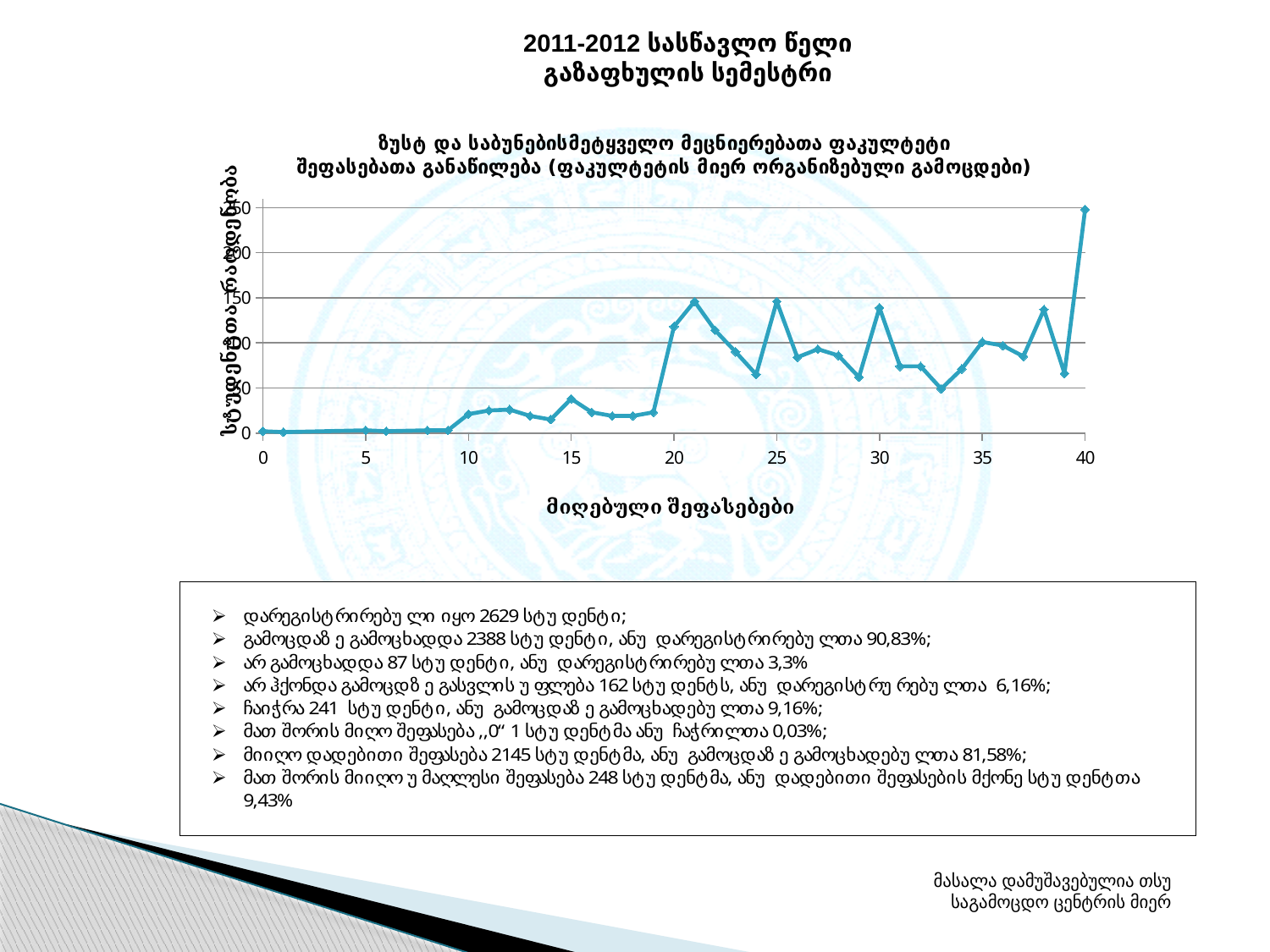
Is the number of students for score 40 greater or less than 200? greater Which score has more students, 40 or 30? 40 Is the number of students for score 5 greater or less than 50? less Which score has more students, 21 or 15? 21 Is the number of students for score 25 greater or less than 100? greater Which x-axis value (score) has the highest number of students? 40 What kind of chart is shown on the slide? line chart What is the label of the x axis of the chart? მიღებული შეფასებები Overall, do the values rise or fall as the score increases along the x axis? rise